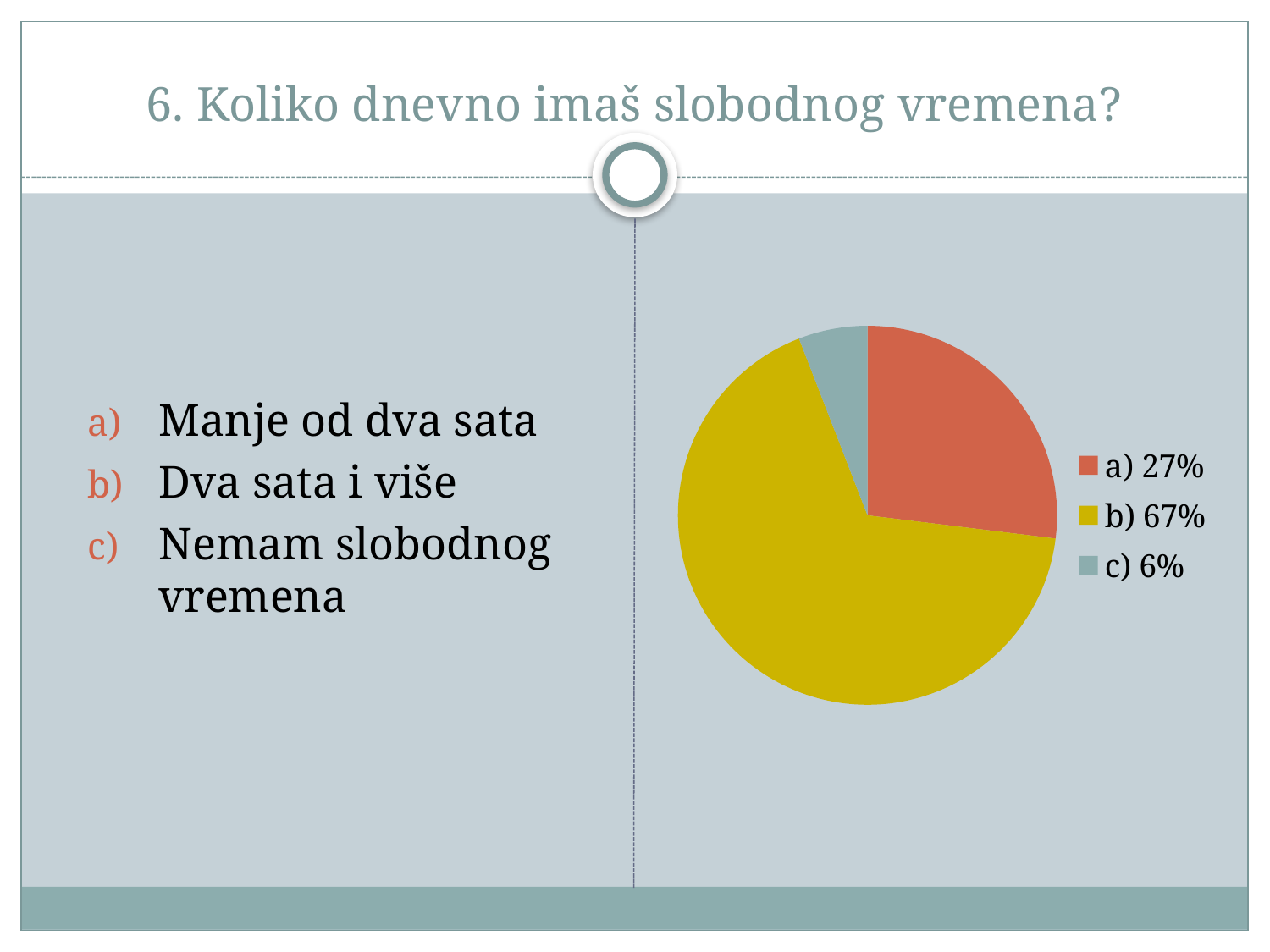
What kind of chart is shown on the slide? pie chart What share of the pie does option b) have? 67% Which option has the smallest slice of the pie? c) Which is larger, the slice for option a) or the slice for option c)? a) What is the difference in percentage points between option b) and option a)? 40 How many entries does the legend list? 3 What is the difference in percentage points between option a) and option c)? 21 What colour is the slice for option b) in the pie chart? yellow How many slices does the pie chart have? 3 Which option has the largest slice of the pie? b) What share of the pie does option c) have? 6% What share of the pie does option a) have? 27%